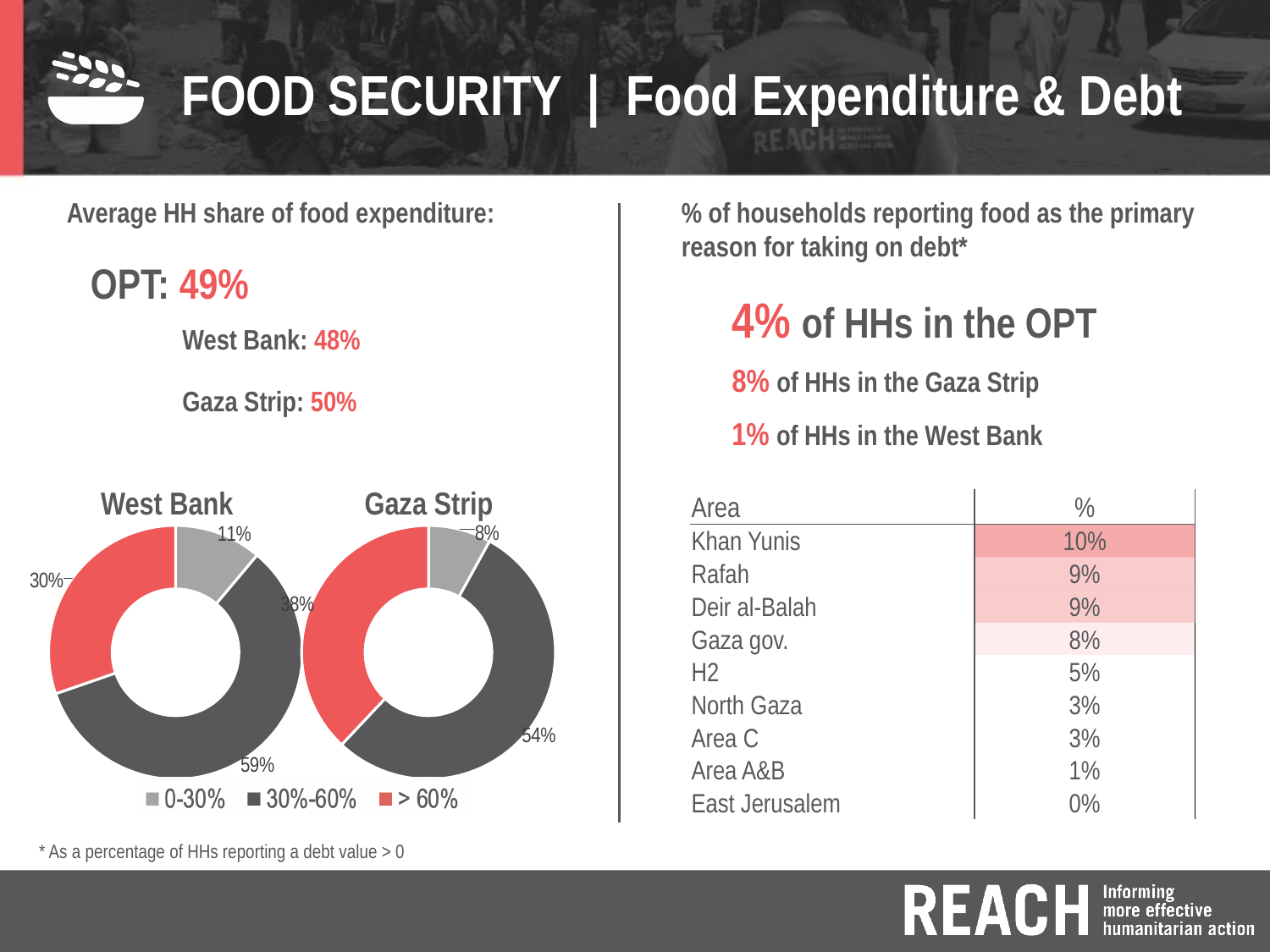
What is the difference between the 0-30% share in the West Bank chart and the 0-30% share in the Gaza Strip chart? 3% How many categories does the legend list for the donut charts? 3 In the West Bank donut chart, which category has the largest share? 30%-60% In the Gaza Strip donut chart, which category has the smallest share? 0-30% What is the difference between the > 60% share in the Gaza Strip chart and the > 60% share in the West Bank chart? 8% In the West Bank donut chart, what share of households spend 30%-60% on food? 59% What colour represents the > 60% category in the donut charts? Red In the Gaza Strip donut chart, what share of households fall in the 0-30% category? 8% In the West Bank donut chart, what share of households fall in the 0-30% category? 11% What type of chart is used to show the West Bank and Gaza Strip food expenditure shares? Donut (pie) chart In the Gaza Strip donut chart, what share of households spend more than 60% on food? 38% Which is larger: the 30%-60% share in the West Bank chart or the 30%-60% share in the Gaza Strip chart? West Bank